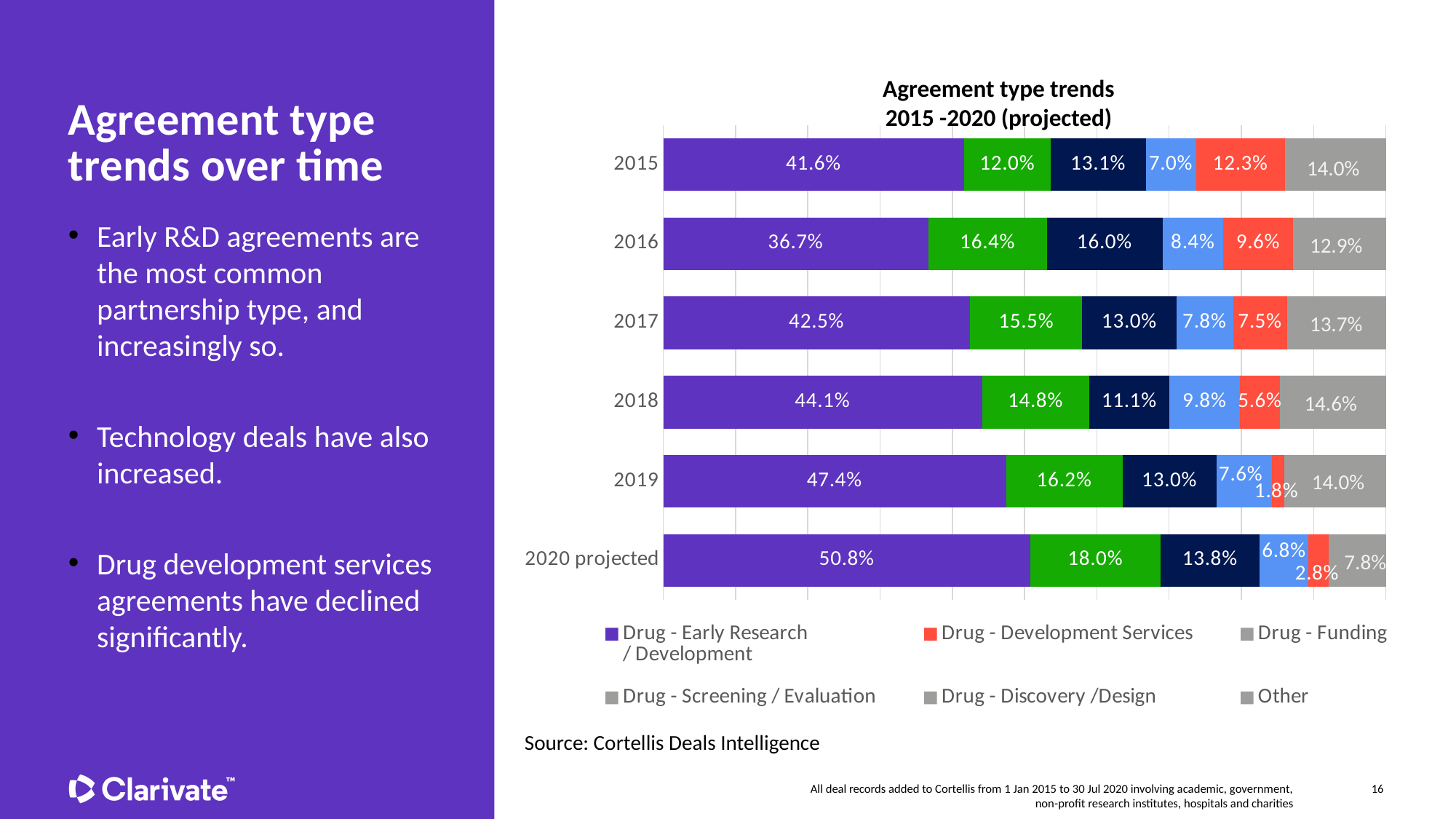
How many years (categories) are shown on the chart? 6 Does the Drug - Development Services value rise or fall from 2015 to 2019? Fall Which year has the larger Drug - Development Services value, 2015 or 2016? 2015 How much higher is the Drug - Early Research / Development value in 2020 projected than in 2015? 9.2% What is the title of the chart? Agreement type trends 2015 -2020 (projected) Which year has the lowest value for Drug - Early Research / Development? 2016 What is the value for Drug - Early Research / Development in 2015? 41.6% What kind of chart is shown on the slide? Stacked bar chart What is the value for Drug - Development Services in 2018? 5.6% What is the value for Drug - Development Services in 2020 projected? 2.8% How many series does the legend list? 6 Which year has the highest value for Drug - Early Research / Development? 2020 projected